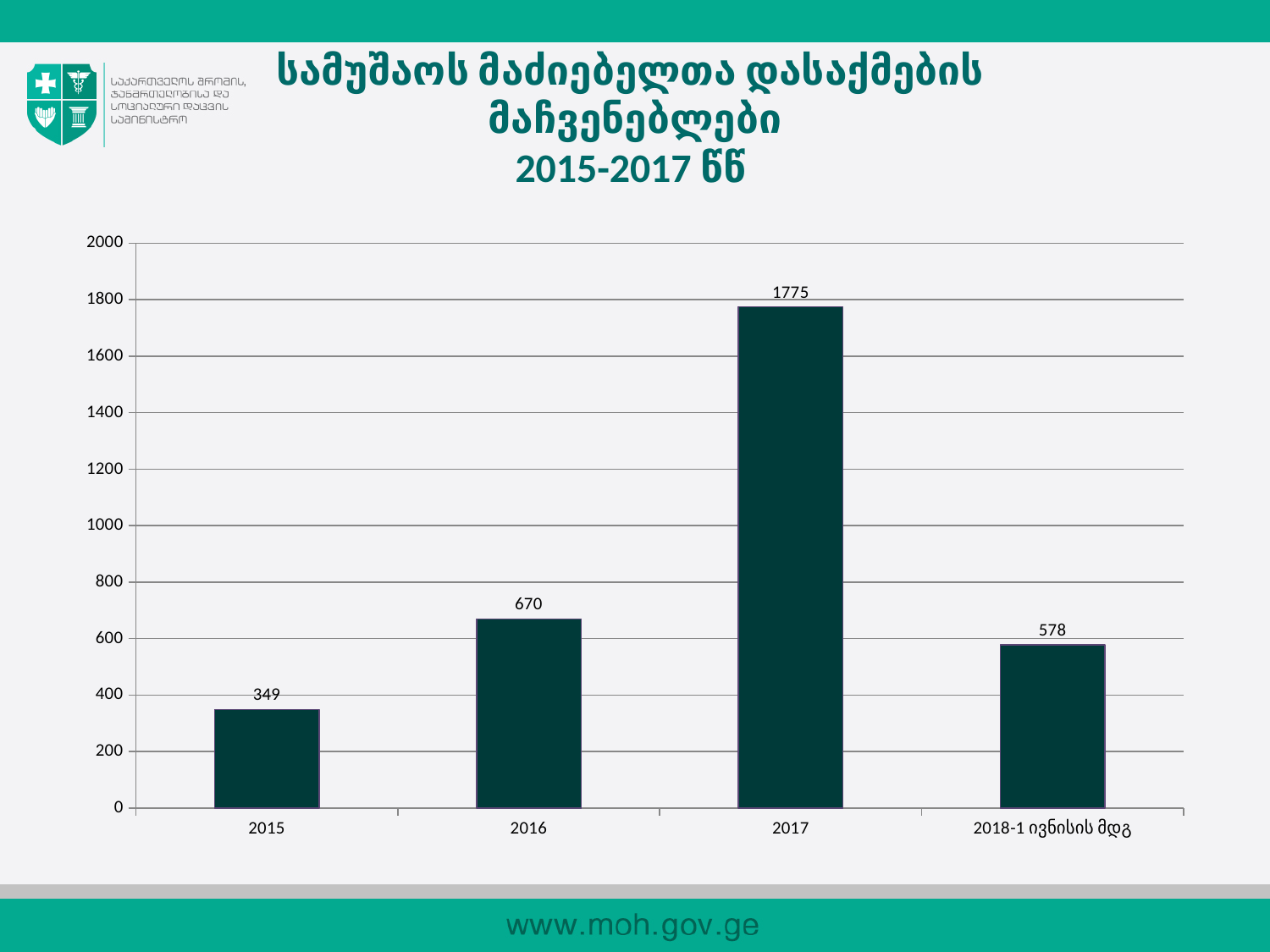
What is the value for the category labelled 2018-1 ივნისის მდე? 578 What is the value for 2017? 1775 What is the value for 2016? 670 Which category has the lowest value? 2015 What is the difference between the values for 2016 and 2015? 321 What is the difference between the values for 2017 and 2016? 1105 How many bars are shown in the chart? 4 What is the value for 2015? 349 Is the value for 2017 greater or less than 1600? greater What kind of chart is shown on the slide? bar chart Which is larger, the value for 2016 or the value for 2018-1 ივნისის მდე? 2016 Which category has the highest value? 2017